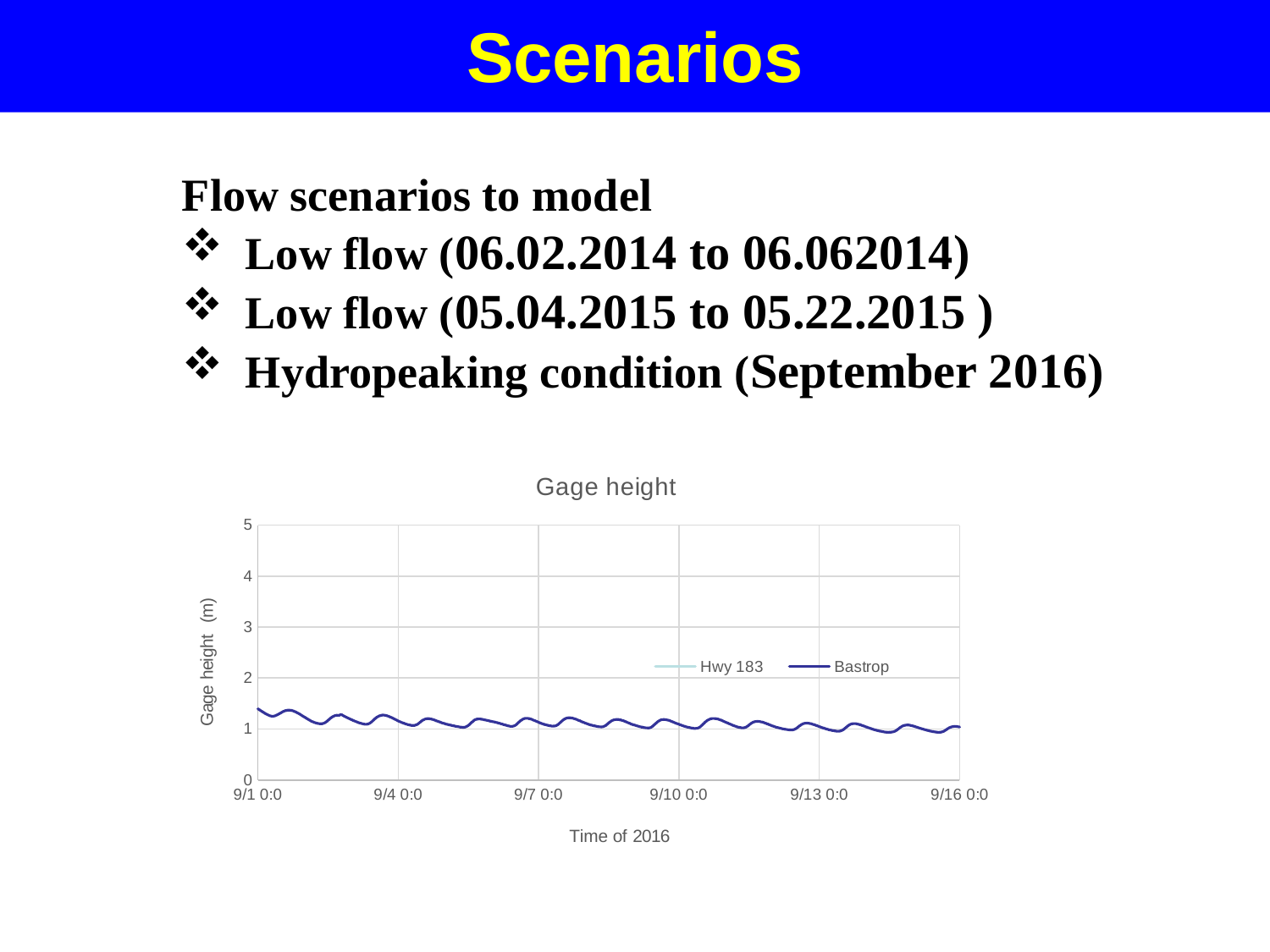
What kind of chart is shown on the slide? line chart Is the Bastrop gage height at 9/16 0:0 greater or less than 3? less What is the title of the chart? Gage height Is the Bastrop gage height at 9/10 0:0 greater or less than 2? less Is the Bastrop gage height at 9/1 0:0 greater or less than 1? greater What is the label of the y axis? Gage height (m) What are the two series named in the chart's legend? Hwy 183 and Bastrop How many labelled tick marks are on the x axis? 6 Does the Bastrop gage height generally rise or fall from 9/1 to 9/16? fall How many series does the chart's legend list? 2